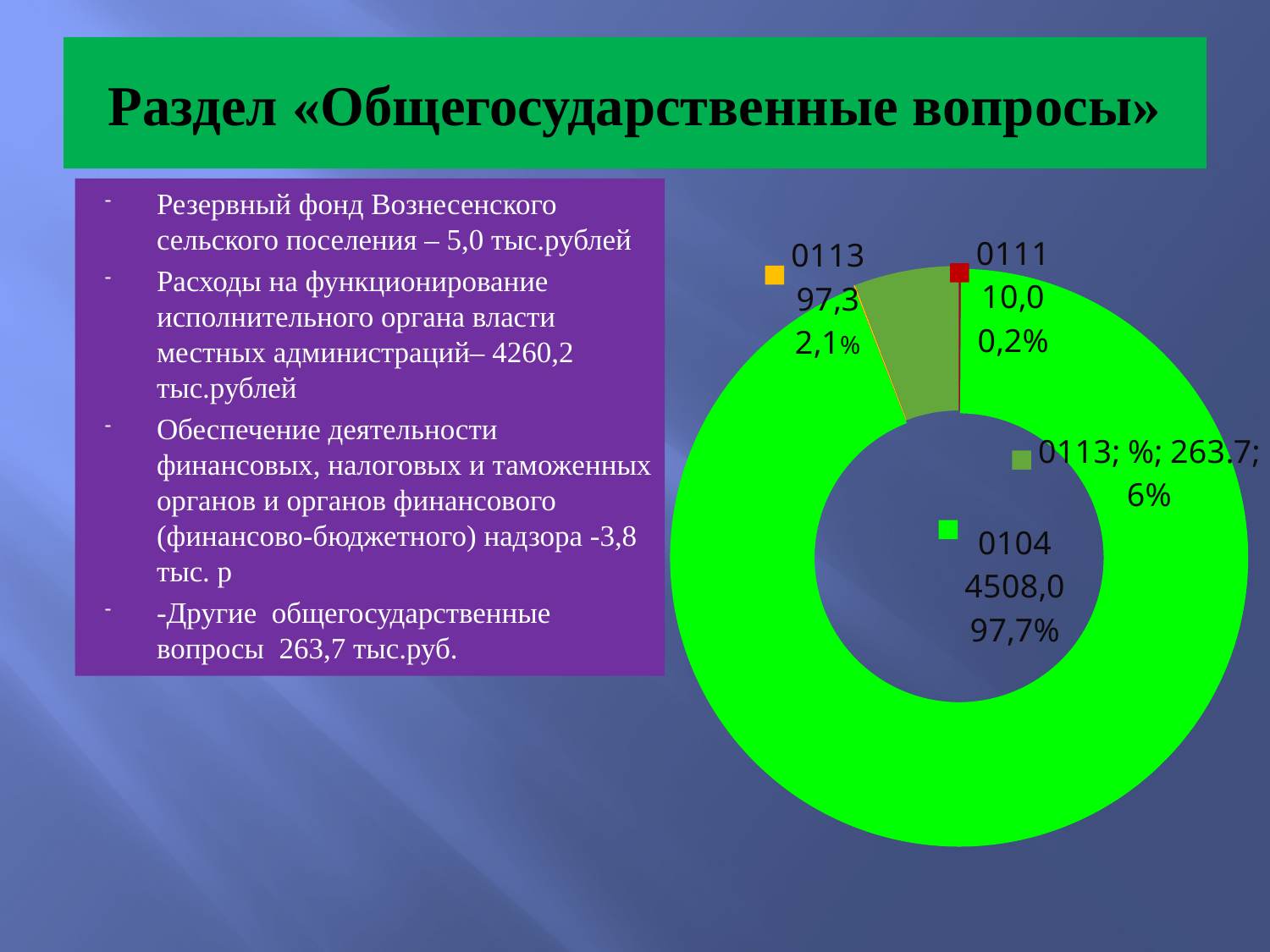
What value is shown for category 0104 in the chart? 4508,0 What percentage share is shown for category 0104? 97,7% What colour is the slice for category 0104? green What value is shown for category 0113 in the label at the top left of the chart? 97,3 Which category has the largest slice in the chart? 0104 Which is larger, the value for 0113 (97,3) or the value for 0111 (10,0)? 0113 What kind of chart is shown on the slide? doughnut chart What percentage share is shown for category 0113 in the label at the top left of the chart? 2,1% What percentage share is shown for category 0111? 0,2% What is the difference between the value for 0104 (4508,0) and the value for 0111 (10,0)? 4498,0 What value is shown for category 0111 in the chart? 10,0